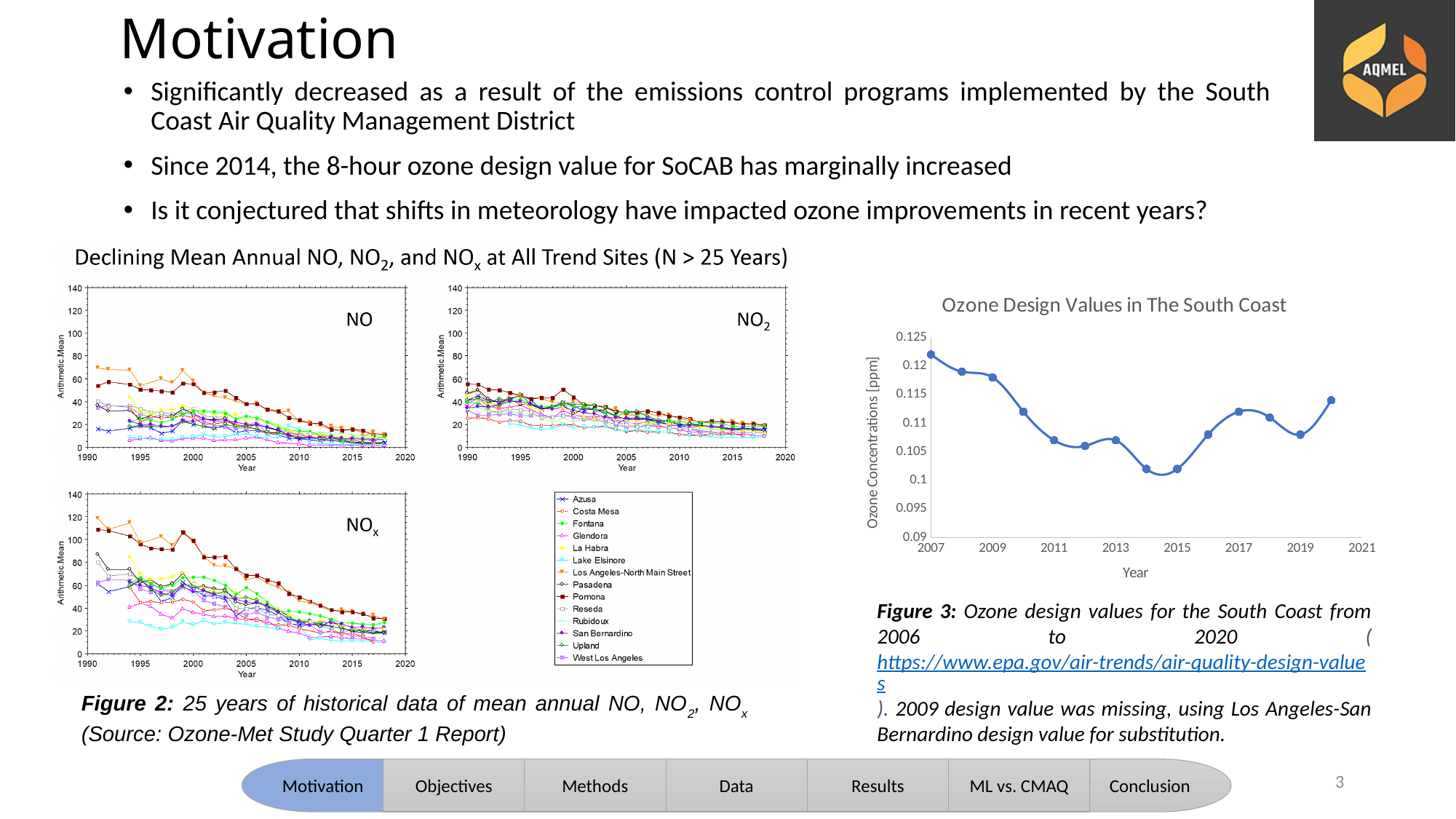
What kind of chart is the 'Ozone Design Values in The South Coast' chart? line chart How many sites does the legend of the Figure 2 NO/NO2/NOx charts list? 14 In the 'Ozone Design Values in The South Coast' chart, which is larger, the value for 2010 or the value for 2015? 2010 In the NOx chart of Figure 2, do the values generally rise or fall from 1990 to 2020? fall How many data points are plotted in the 'Ozone Design Values in The South Coast' chart? 14 What is the y-axis label of the 'Ozone Design Values in The South Coast' chart? Ozone Concentrations [ppm] In the 'Ozone Design Values in The South Coast' chart, which year has the highest ozone design value? 2007 In the 'Ozone Design Values in The South Coast' chart, is the value for 2007 greater or less than 0.12? greater What is the maximum value shown on the y-axis of the NO chart in Figure 2? 140 In the NOx chart of Figure 2, is the value for Los Angeles-North Main Street in 1991 greater or less than 100? greater In the 'Ozone Design Values in The South Coast' chart, is the value for 2020 greater or less than 0.11? greater